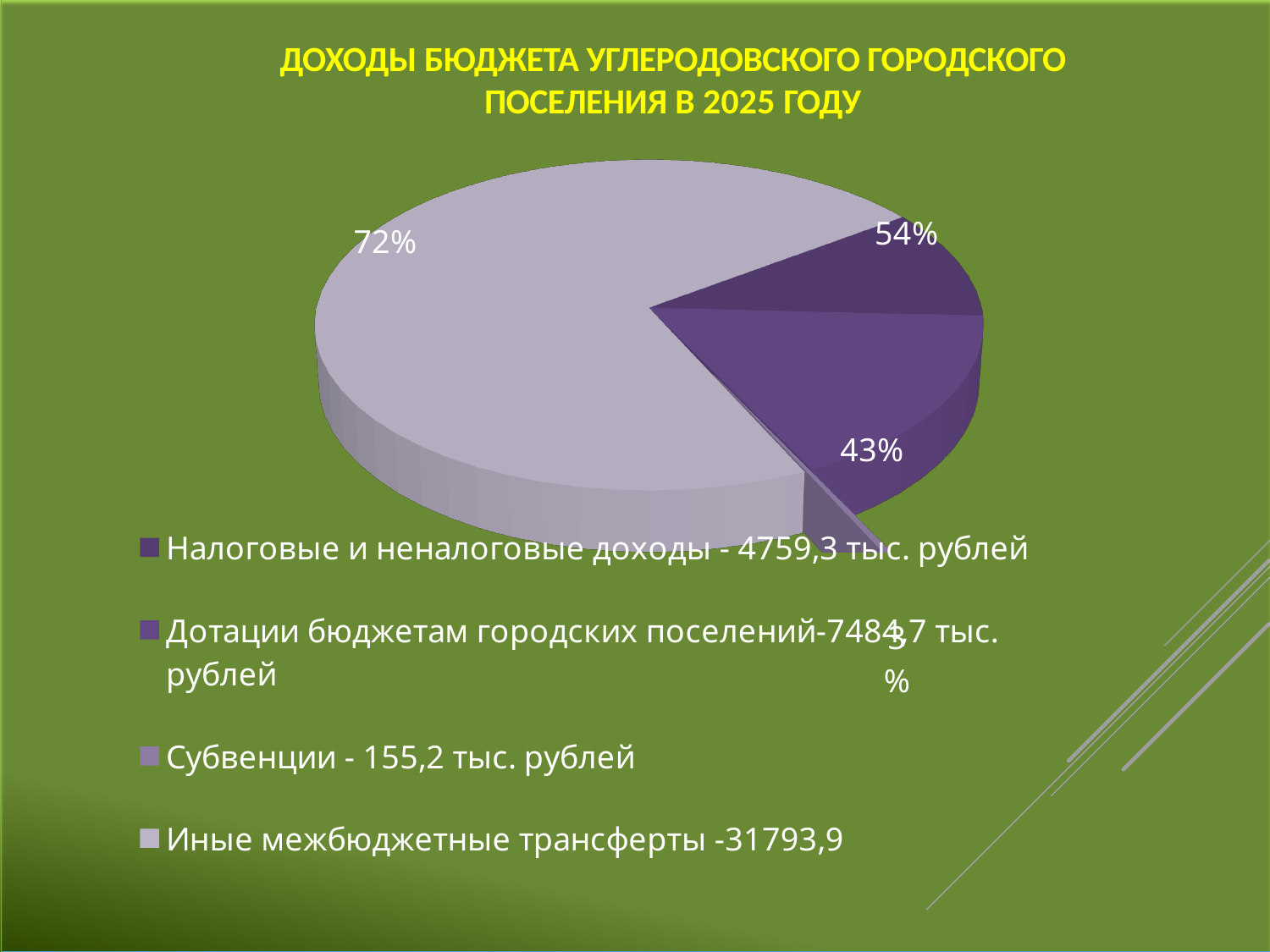
Which is larger according to the legend: Дотации бюджетам городских поселений or Налоговые и неналоговые доходы? Дотации бюджетам городских поселений What value does the legend give for Налоговые и неналоговые доходы? 4759,3 тыс. рублей Which category has the smallest value in the legend? Субвенции How many categories does the legend of the pie chart list? 4 What percentage label is shown on the largest slice of the pie? 72% What value does the legend give for Дотации бюджетам городских поселений? 7484,7 тыс. рублей By how much does the legend value for Дотации бюджетам городских поселений exceed that for Налоговые и неналоговые доходы? 2725,4 тыс. рублей Which category has the largest slice of the pie? Иные межбюджетные трансферты What kind of chart is shown on the slide? Pie chart What value does the legend give for Субвенции? 155,2 тыс. рублей What value does the legend give for Иные межбюджетные трансферты? 31793,9 What is the title of the chart on the slide? ДОХОДЫ БЮДЖЕТА УГЛЕРОДОВСКОГО ГОРОДСКОГО ПОСЕЛЕНИЯ В 2025 ГОДУ